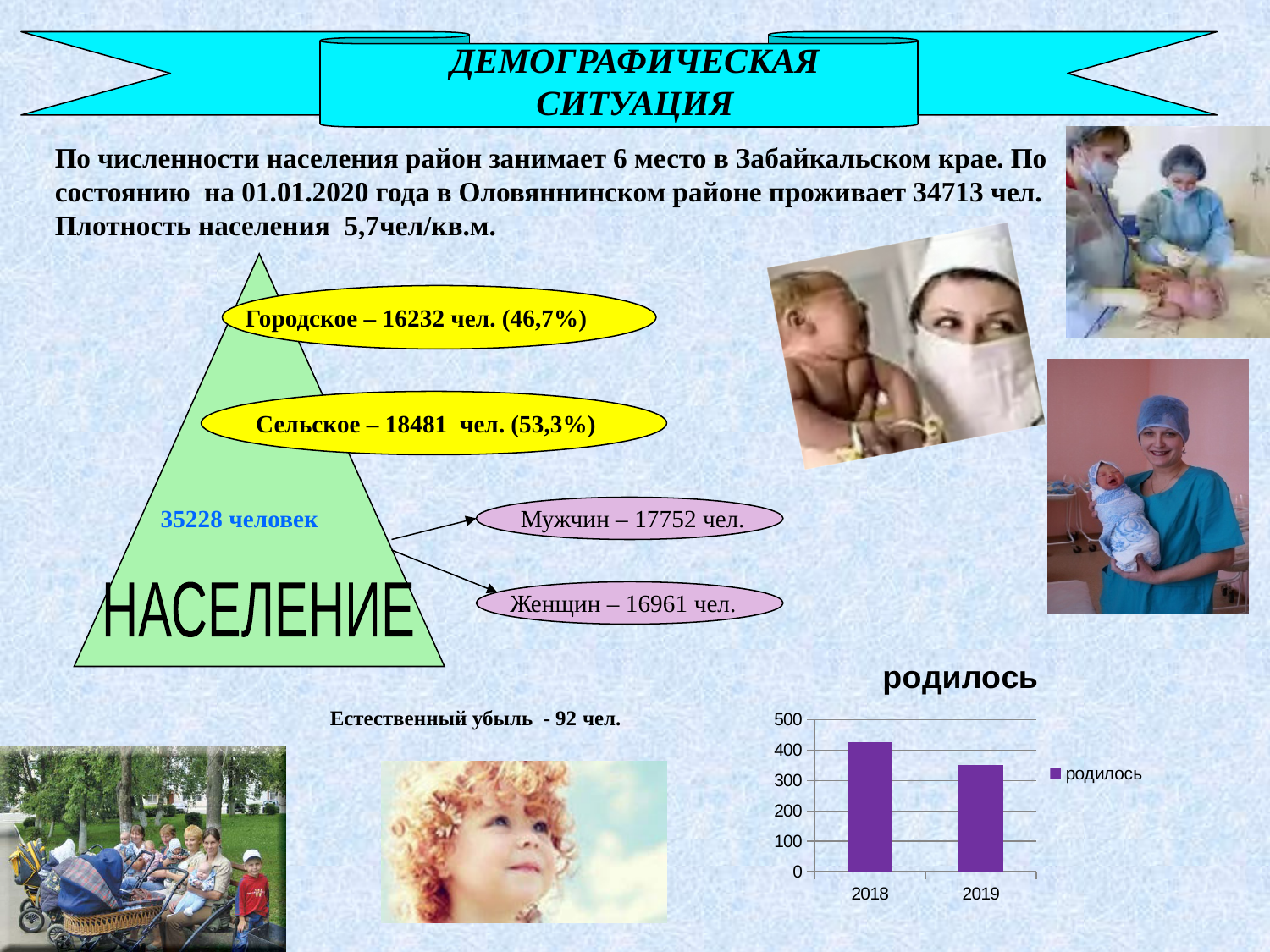
In the "родилось" chart, is the value for 2019 greater or less than 400? less Do the values in the "родилось" chart rise or fall from 2018 to 2019? fall In the "родилось" chart, is the value for 2019 greater or less than 300? greater In the "родилось" chart, is the value for 2018 greater or less than 400? greater What entry is listed in the legend of the "родилось" chart? родилось Which year has the highest value in the "родилось" chart? 2018 What is the title of the bar chart on the slide? родилось How many series does the legend of the "родилось" chart list? 1 In the "родилось" chart, which is larger: the value for 2018 or for 2019? 2018 What kind of chart is the "родилось" chart? bar chart How many categories are shown on the x axis of the "родилось" chart? 2 Which year has the lowest value in the "родилось" chart? 2019